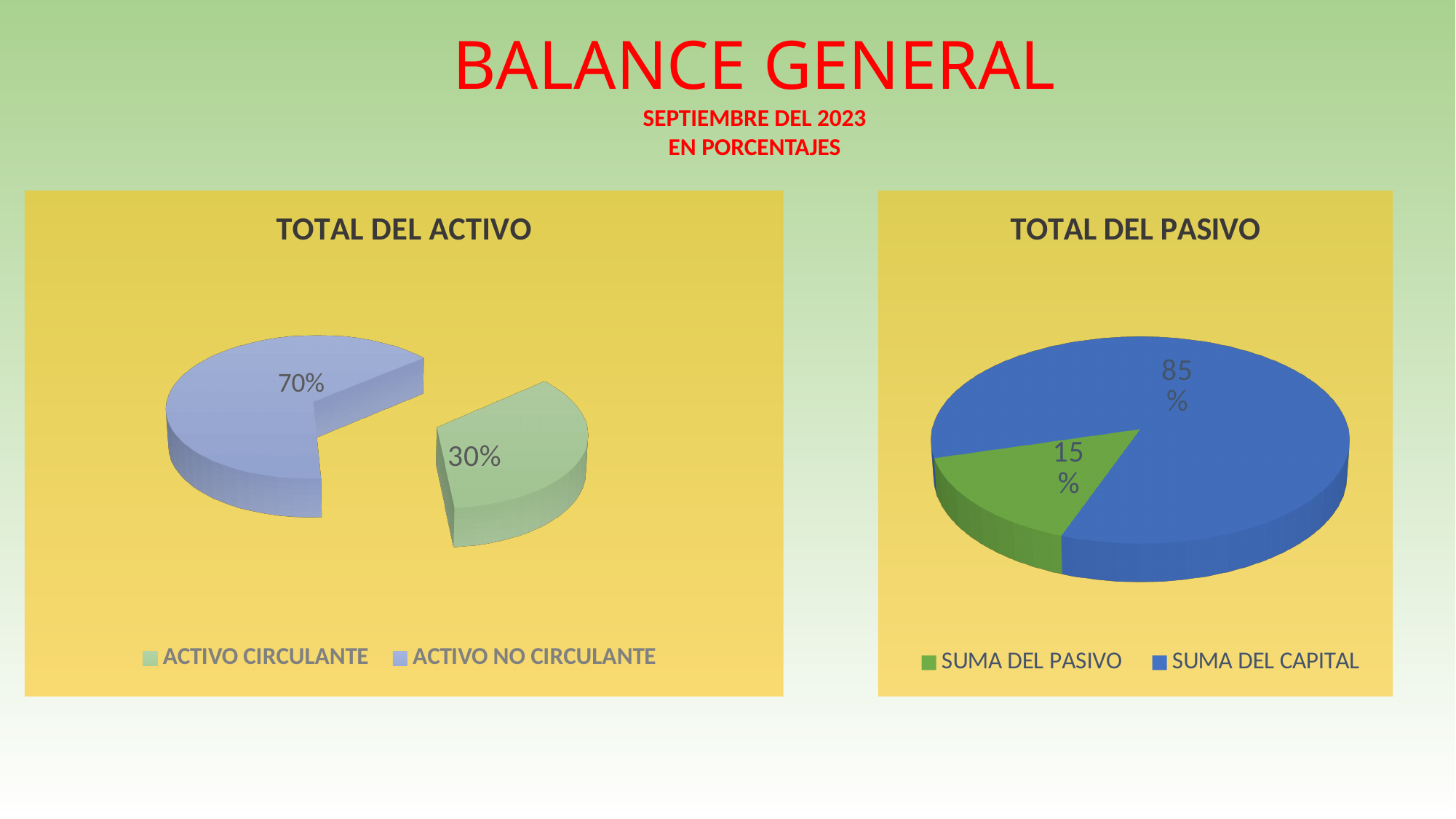
In the TOTAL DEL ACTIVO chart, what percentage is ACTIVO CIRCULANTE? 30% What kind of chart is the TOTAL DEL ACTIVO chart? Pie chart In the TOTAL DEL ACTIVO chart, which category has the largest share? ACTIVO NO CIRCULANTE In the TOTAL DEL PASIVO chart, what is the difference in percentage points between SUMA DEL CAPITAL and SUMA DEL PASIVO? 70 In the TOTAL DEL PASIVO chart, which category has the smallest share? SUMA DEL PASIVO In the TOTAL DEL ACTIVO chart, what percentage is ACTIVO NO CIRCULANTE? 70% In the TOTAL DEL ACTIVO chart, what colour is the ACTIVO CIRCULANTE slice? Green In the TOTAL DEL PASIVO chart, which is larger, SUMA DEL PASIVO or SUMA DEL CAPITAL? SUMA DEL CAPITAL In the TOTAL DEL PASIVO chart, what percentage is SUMA DEL CAPITAL? 85% In the TOTAL DEL ACTIVO chart, what is the difference in percentage points between ACTIVO NO CIRCULANTE and ACTIVO CIRCULANTE? 40 In the TOTAL DEL PASIVO chart, what percentage is SUMA DEL PASIVO? 15% How many categories does the TOTAL DEL PASIVO chart show? 2